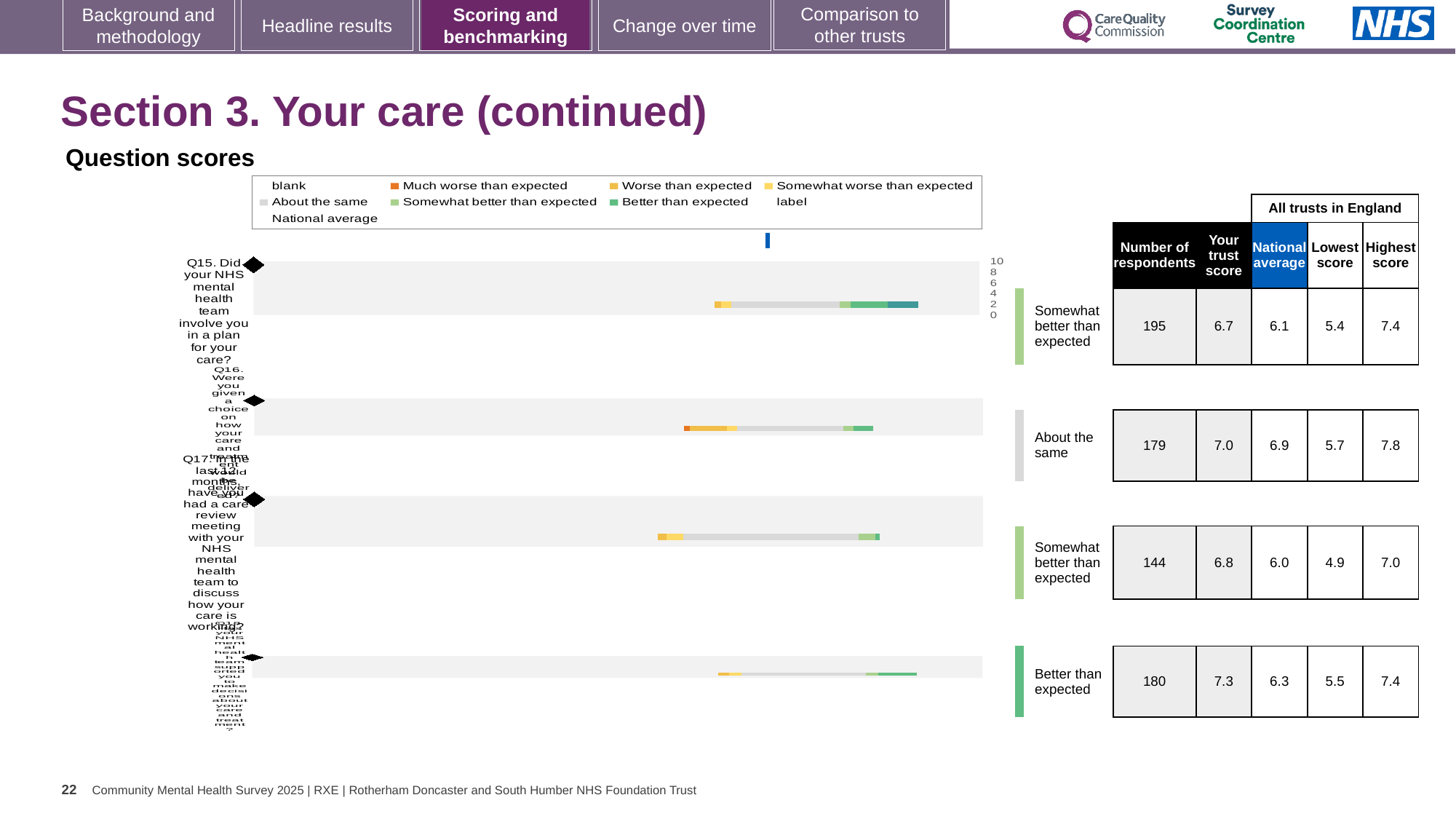
In the question scores chart legend, which colour represents 'Better than expected'? green What is the difference between the trust score and the national average for Q15? 0.6 What kind of chart is used to show the question scores on this slide? bar chart What is the national average score for Q17 (care review meeting in the last 12 months)? 6.0 How many respondents answered Q16 (given a choice on how your care and treatment would be delivered)? 179 Which question row has the highest 'Your trust score'? the bottom (fourth) row, 7.3 In the question scores chart legend, which colour represents 'Much worse than expected'? orange Is the trust score for Q16 larger or smaller than the trust score for Q17? larger Which question row has the lowest number of respondents? Q17 What is the 'Your trust score' for Q15 (involving you in a plan for your care)? 6.7 How many question bars are plotted in the question scores chart? 4 What is the highest score among all trusts in England for the bottom (fourth) question row? 7.4